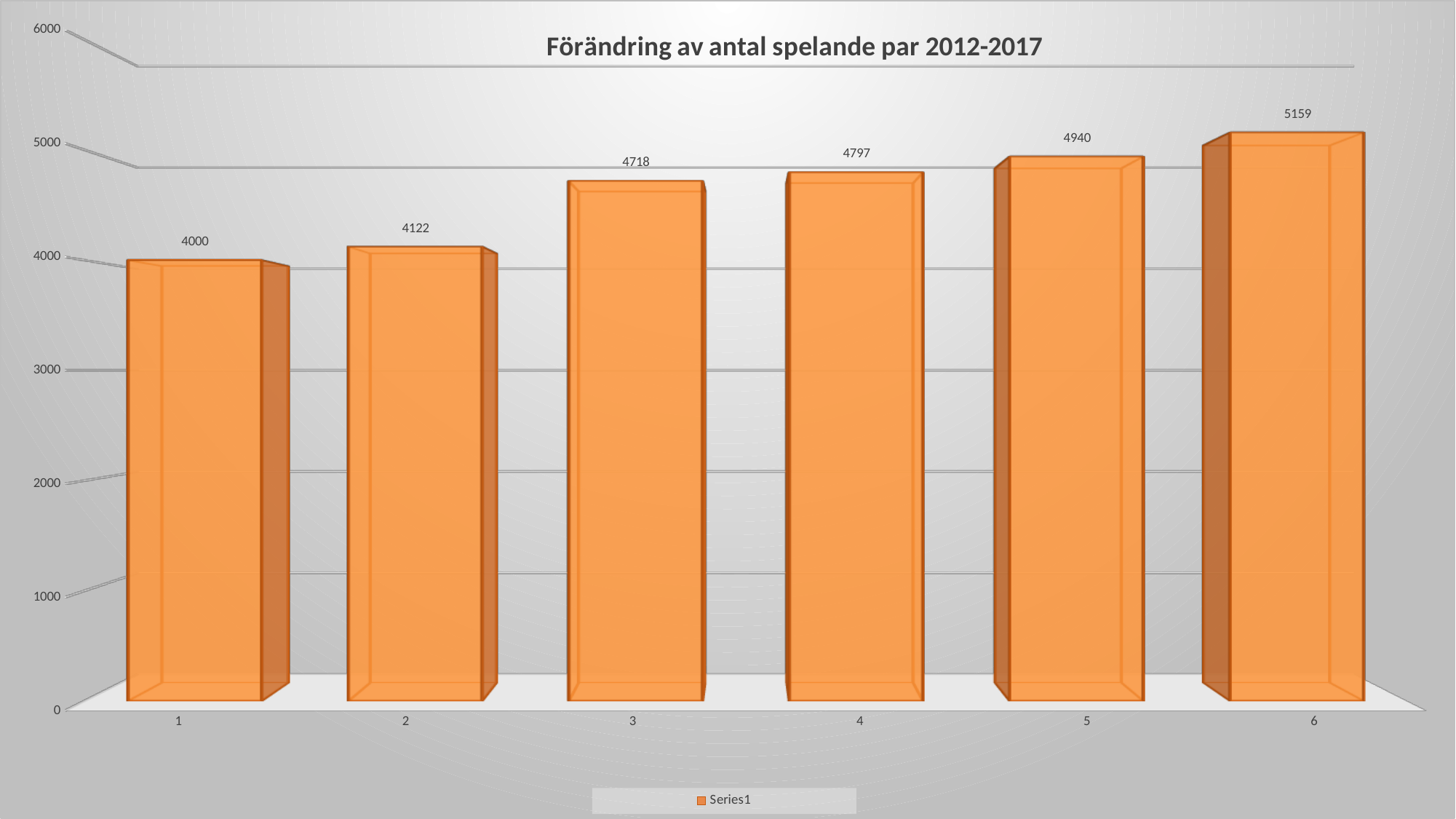
What is the value for category 6? 5159 What kind of chart is shown on the slide? bar chart What is the difference between the values for category 6 and category 1? 1159 How many bars are shown in the chart? 6 What is the value for category 4? 4797 Which category has the highest value? 6 Do the values rise or fall from category 1 to category 6? rise How many series does the legend list? 1 What is the difference between the values for category 3 and category 2? 596 Which category has the lowest value? 1 What is the value for category 1? 4000 Which is larger, the value for category 5 or the value for category 3? 5